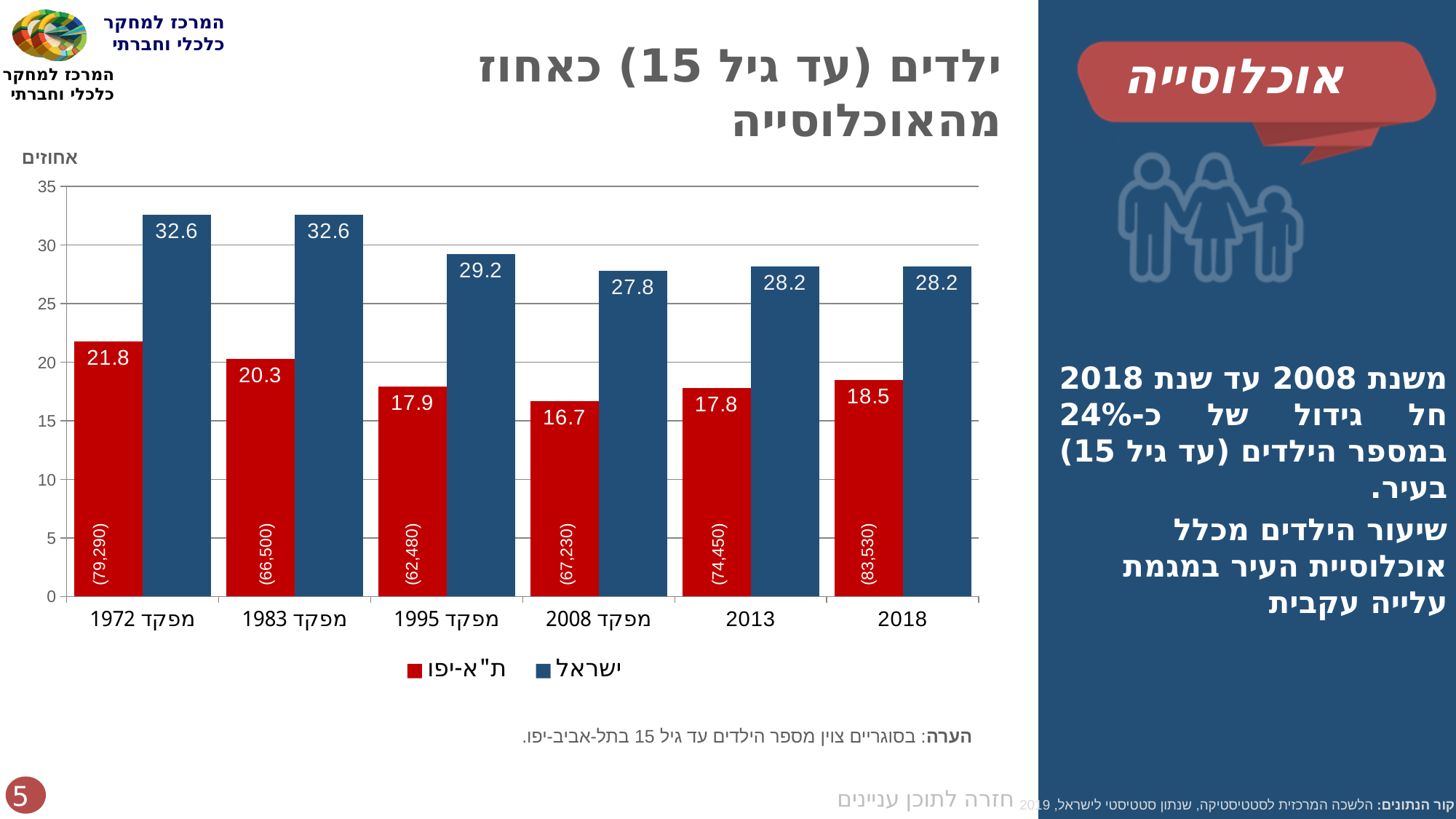
What is the highest value shown for the ישראל series? 32.6 In which category is the ת"א-יפו value lowest? מפקד 2008 What is the value for ת"א-יפו in מפקד 1972? 21.8 What kind of chart is shown on the slide? bar chart What number is printed in parentheses inside the ת"א-יפו bar for 2018? (83,530) What is the difference between the ישראל and ת"א-יפו values in 2018? 9.7 How many categories are shown on the x axis? 6 Which is larger in מפקד 1995: the value for ישראל or for ת"א-יפו? ישראל Is the value for ת"א-יפו in 2013 greater or less than 20? less How many series does the legend list? 2 Does the ת"א-יפו value rise or fall from מפקד 1972 to מפקד 2008? fall What is the value for ישראל in מפקד 2008? 27.8